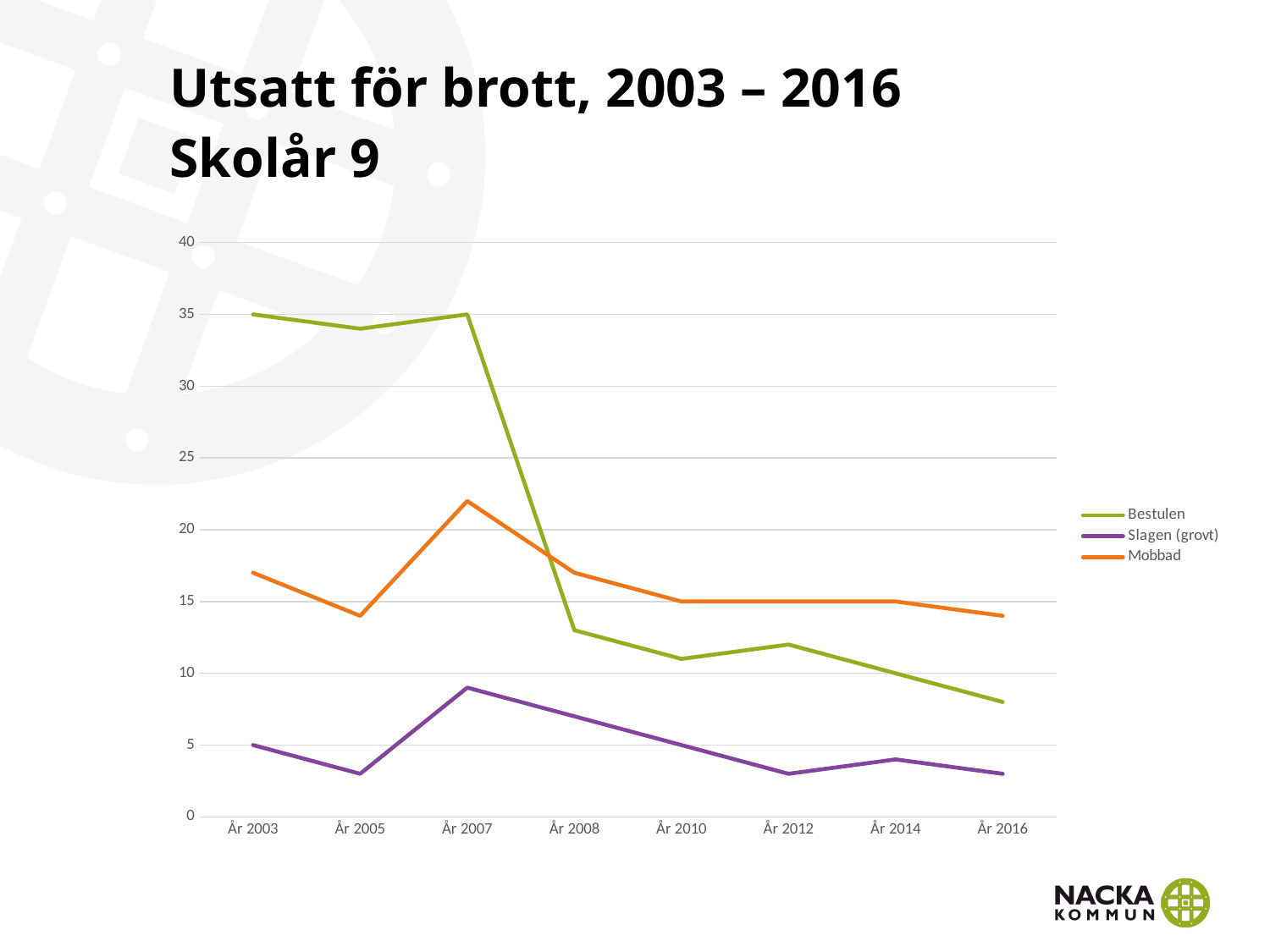
How many series does the legend list? 3 What is the value for Mobbad in År 2010? 15 How many years are shown along the x axis? 8 Is the value for Mobbad in År 2007 greater or less than 20? greater What is the value for Bestulen in År 2003? 35 In which year is the Mobbad series at its highest? År 2007 What kind of chart is shown on the slide? Line chart In År 2016, which series has the larger value, Bestulen or Mobbad? Mobbad What is the value for Slagen (grovt) in År 2003? 5 In which year is the Bestulen series at its lowest? År 2016 Is the value for Bestulen in År 2016 greater or less than 10? less Does the Bestulen series rise or fall overall from År 2003 to År 2016? Fall